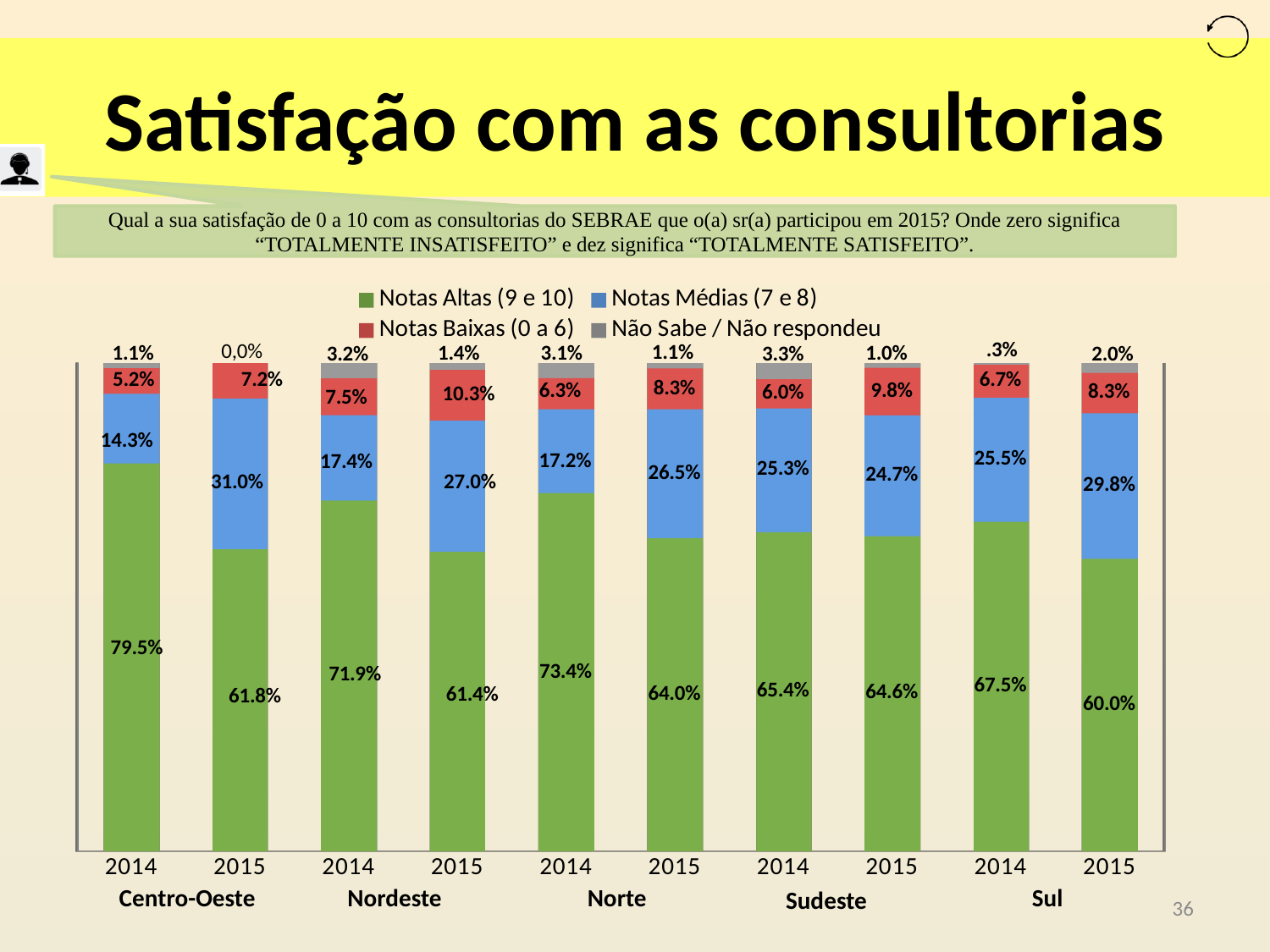
What is the value of Notas Altas (9 e 10) for Centro-Oeste in 2014? 79.5% Which bar has the lowest value for Notas Altas (9 e 10)? Sul 2015 What kind of chart is shown on the slide? Stacked bar chart How many bars are plotted in the chart? 10 Which colour represents Notas Baixas (0 a 6) in the chart? Red What is the value of Notas Baixas (0 a 6) for Nordeste in 2015? 10.3% By how many percentage points did Notas Altas (9 e 10) for Centro-Oeste change from 2014 to 2015? 17.7 percentage points What is the value of Notas Médias (7 e 8) for Sul in 2015? 29.8% How many series does the legend list? 4 Which is larger: Notas Médias (7 e 8) for Centro-Oeste in 2015 or for Nordeste in 2015? Centro-Oeste 2015 What is the value of Não Sabe / Não respondeu for Sudeste in 2014? 3.3% Which bar has the highest value for Notas Altas (9 e 10)? Centro-Oeste 2014